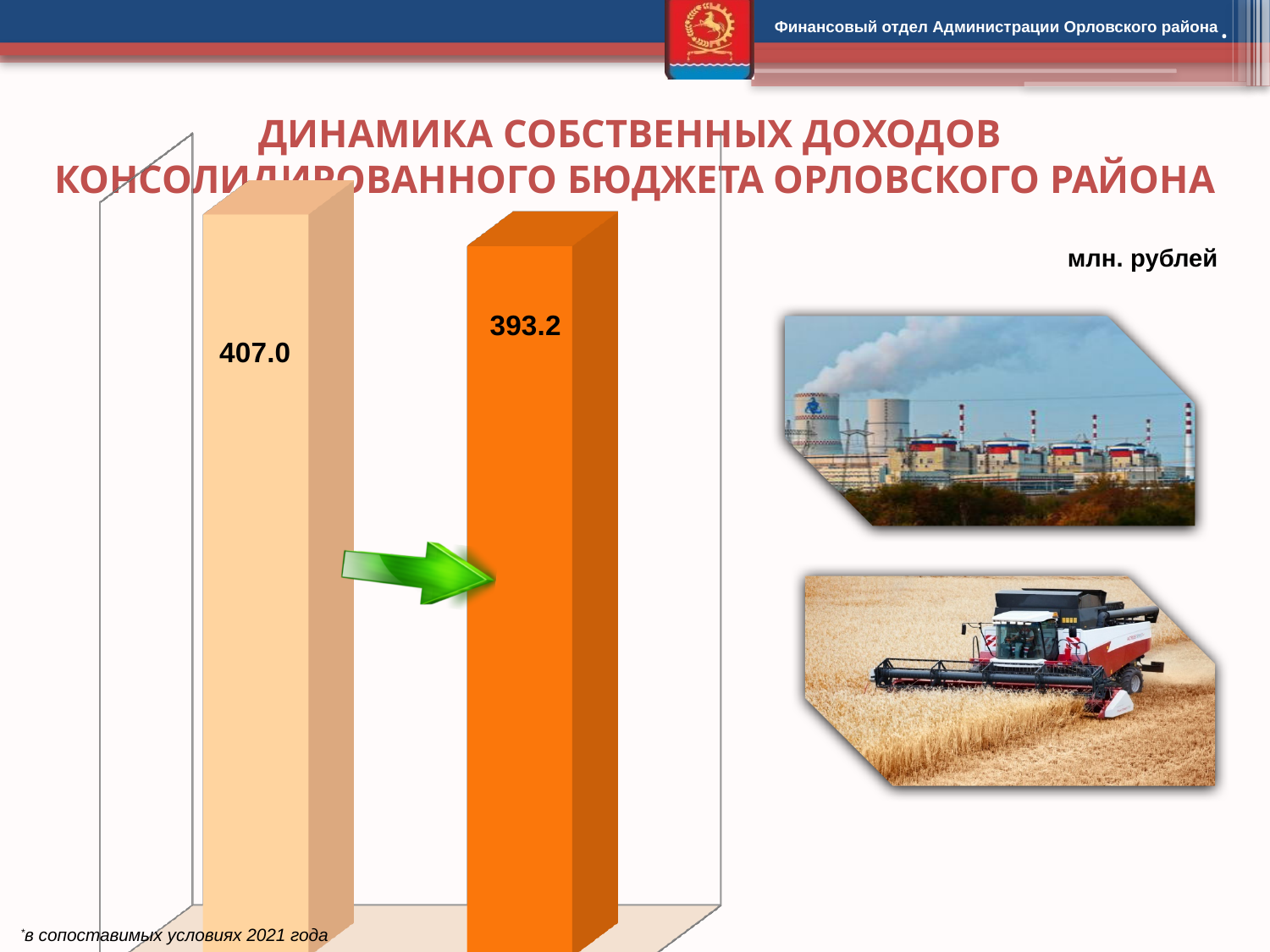
What value is shown on the right (orange) bar of the chart? 393.2 Is the value of the orange bar larger or smaller than the value of the light peach bar? smaller Do the values rise or fall from the left bar to the right bar? fall What value is shown on the left (light peach) bar of the chart? 407.0 Which bar has the higher value, the left one or the right one? the left one In what units are the chart values given, according to the slide? млн. рублей How many bars are plotted on the chart? 2 What kind of chart is shown on the slide? bar chart What is the title of the chart on the slide? ДИНАМИКА СОБСТВЕННЫХ ДОХОДОВ КОНСОЛИДИРОВАННОГО БЮДЖЕТА ОРЛОВСКОГО РАЙОНА What is the difference between the left bar's value and the right bar's value? 13.8 Which bar has the lower value, the left one or the right one? the right one